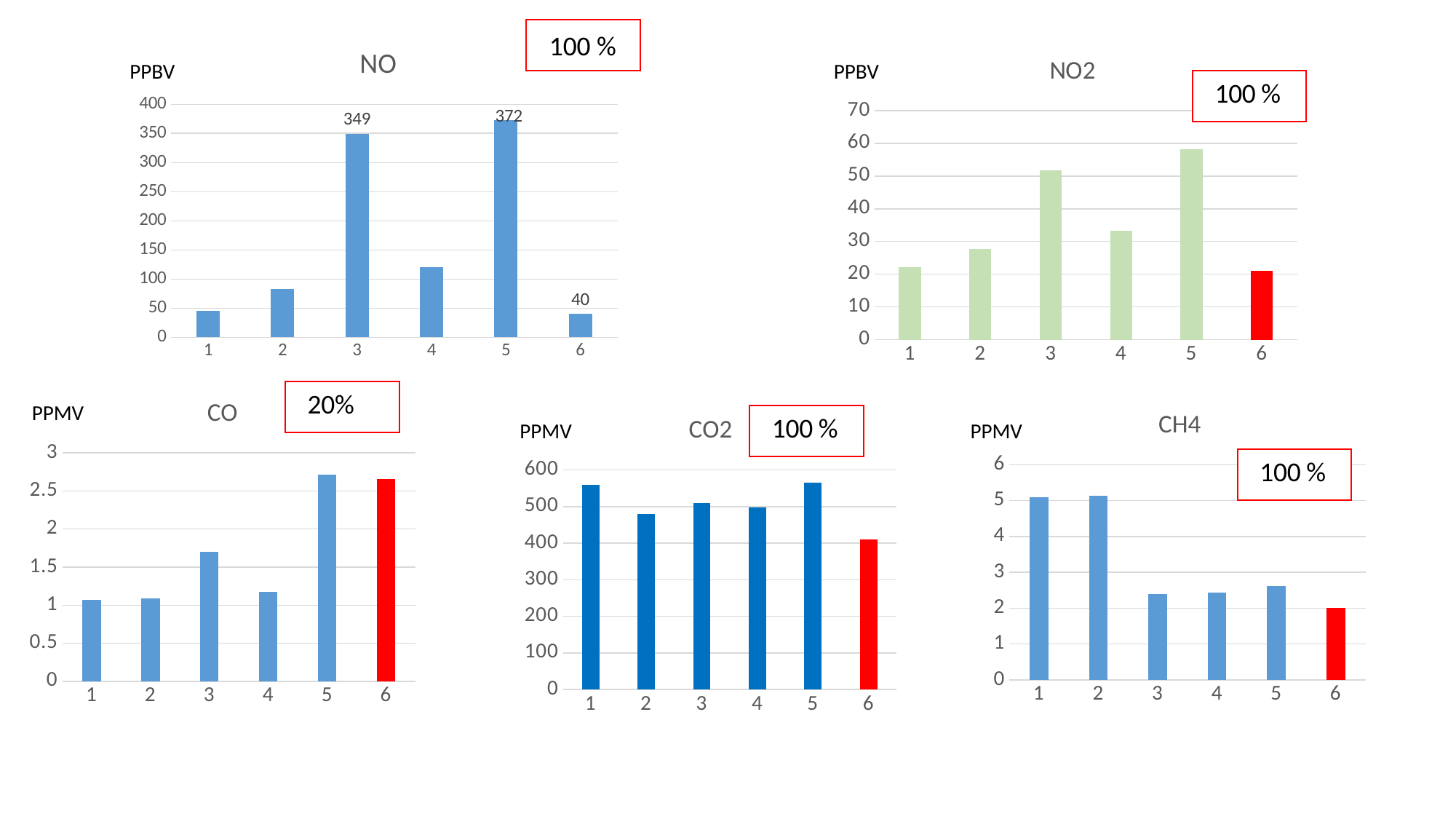
In the NO chart, what is the difference between the values for category 5 and category 3? 23 In the CO2 chart, which category has the lowest value? 6 In the CH4 chart, which category has the lowest value? 6 In the NO chart, what is the value for category 6? 40 In the NO chart, what is the value for category 3? 349 In the NO chart, how many categories are shown on the x axis? 6 In the NO2 chart, which category has the highest value? 5 In the CO chart, is the value for category 3 greater or less than 1.5? greater In the NO2 chart, is the value for category 4 greater or less than 30? greater In the NO chart, what is the value for category 5? 372 In the NO chart, which category has the highest value? 5 What kind of chart is the CO2 chart? bar chart